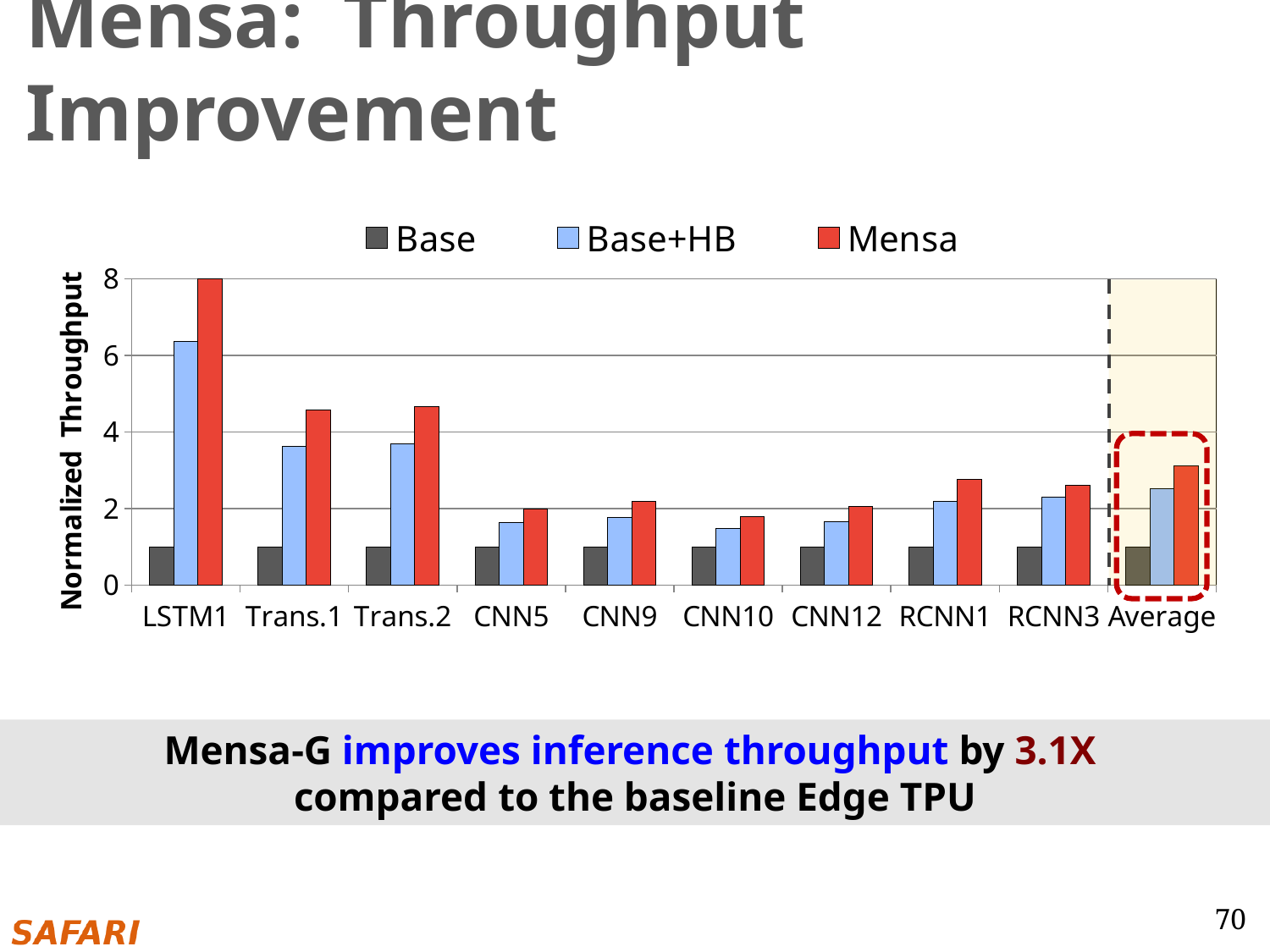
Is the Mensa value for Trans.1 greater or less than 4? greater How many categories are shown along the x axis? 10 Which category has the lowest Mensa bar? CNN10 What kind of chart is shown on the slide? bar chart Which category has the highest Mensa bar? LSTM1 Is the Base+HB value for LSTM1 greater or less than 6? greater Is the Mensa value for Average greater or less than 2? greater How many series does the legend list? 3 Which is larger: the Base+HB value for LSTM1 or the Mensa value for Trans.1? Base+HB value for LSTM1 What is the label of the y axis? Normalized Throughput Which category is enclosed by the red dashed box? Average